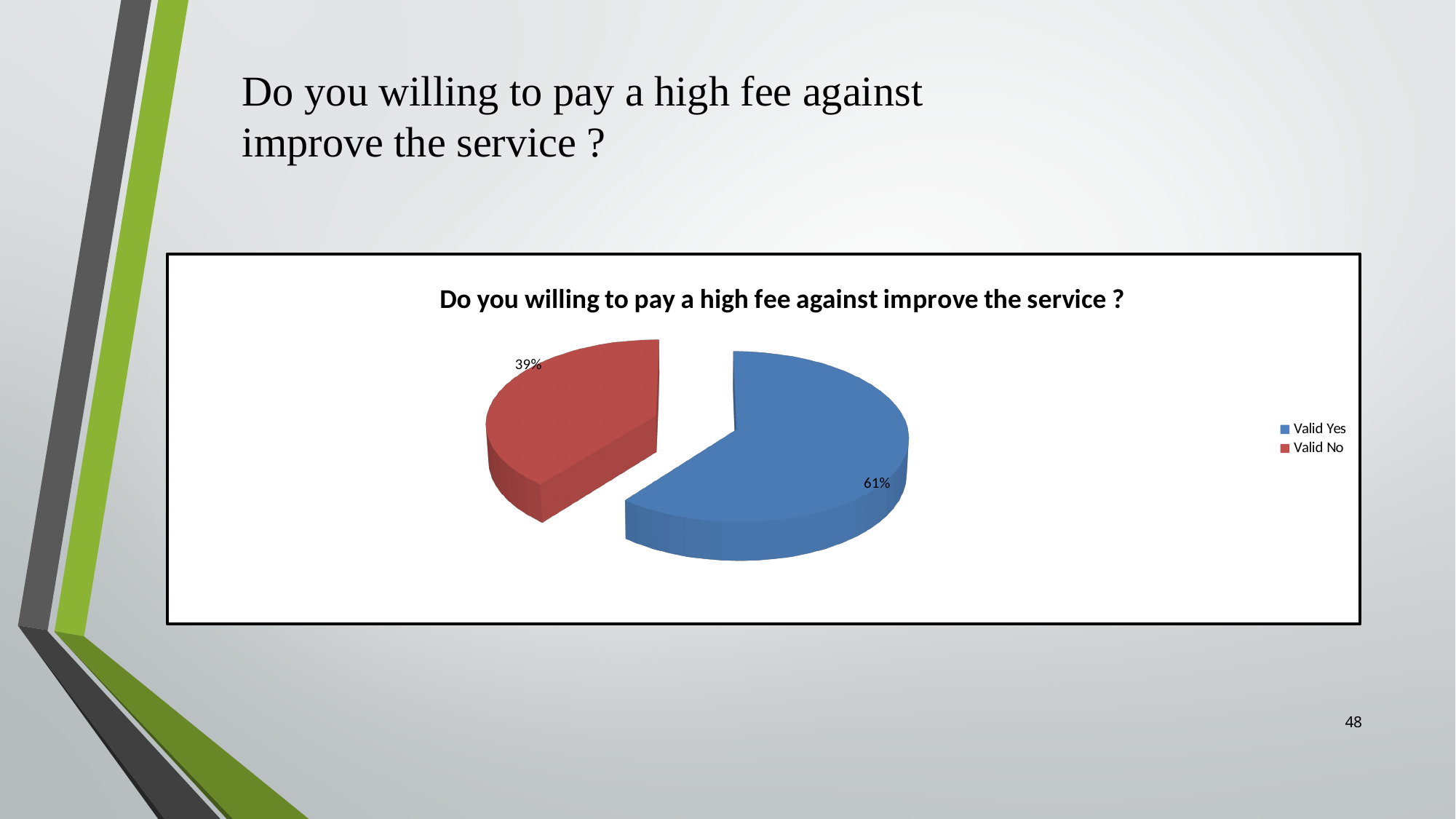
What is the difference in percentage points between Valid Yes and Valid No? 22 How many entries does the legend list? 2 Which category has the largest share of the pie? Valid Yes What percentage of respondents answered Valid Yes? 61% What is the title of the chart? Do you willing to pay a high fee against improve the service ? What colour is the Valid No slice? red Which category has the smallest share of the pie? Valid No What kind of chart is shown on the slide? pie chart How many slices does the pie chart have? 2 Which is larger, the share for Valid Yes or the share for Valid No? Valid Yes What percentage of respondents answered Valid No? 39%